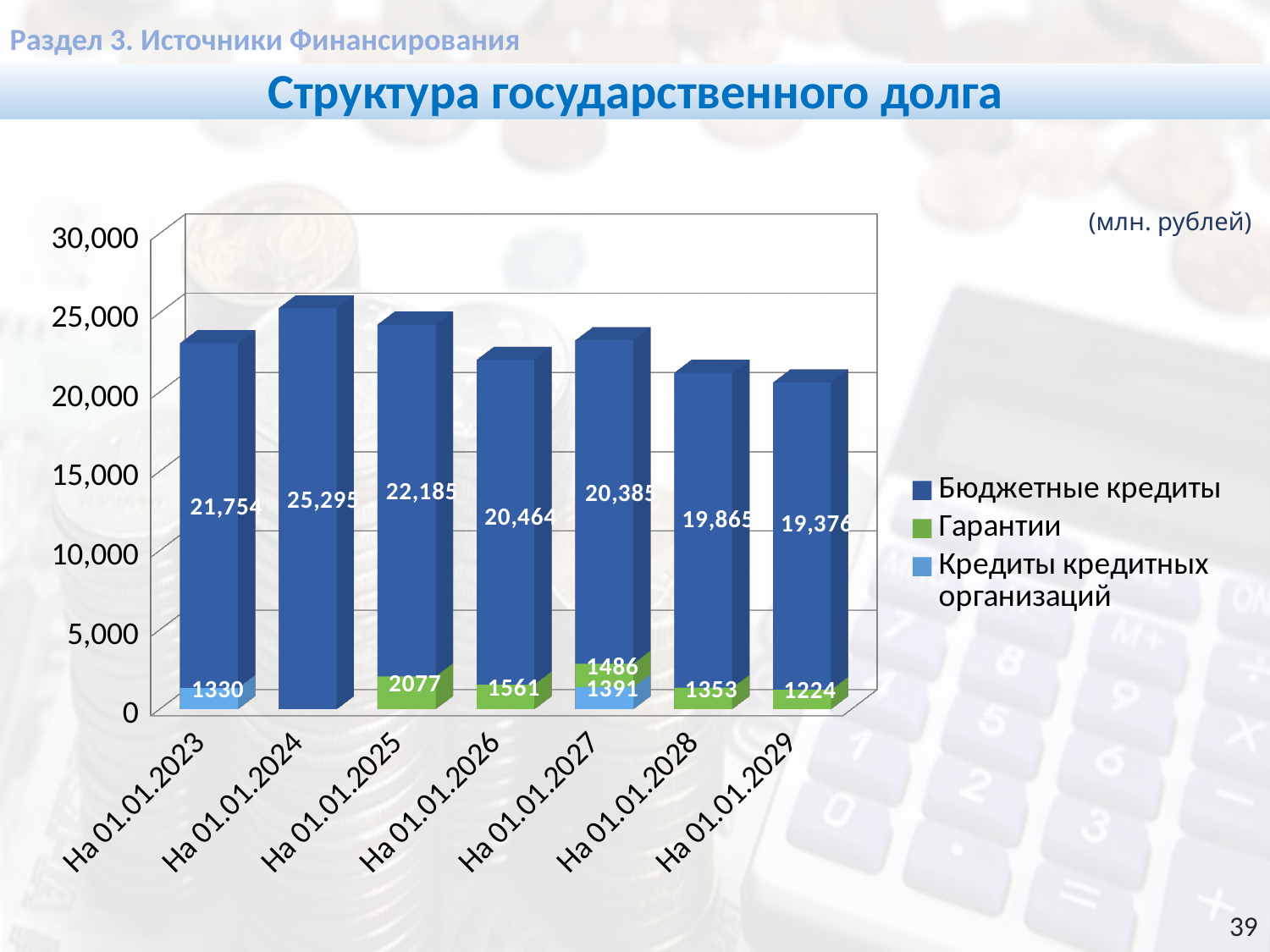
Which is larger, Гарантии for На 01.01.2026 or for На 01.01.2028? На 01.01.2026 What is the value of Гарантии for На 01.01.2025? 2077 What is the difference between Бюджетные кредиты for На 01.01.2024 and На 01.01.2023? 3,541 Which date has the highest value of Бюджетные кредиты? На 01.01.2024 What kind of chart is shown on the slide? Stacked bar chart Which date has the lowest value of Бюджетные кредиты? На 01.01.2029 What is the value of Бюджетные кредиты for На 01.01.2024? 25,295 What is the total of the stacked bar for На 01.01.2023? 23,084 Do the values of Гарантии rise or fall from На 01.01.2025 to На 01.01.2029? Fall How many dates (categories) are shown on the x axis? 7 What is the value of Кредиты кредитных организаций for На 01.01.2027? 1391 How many series does the legend list? 3